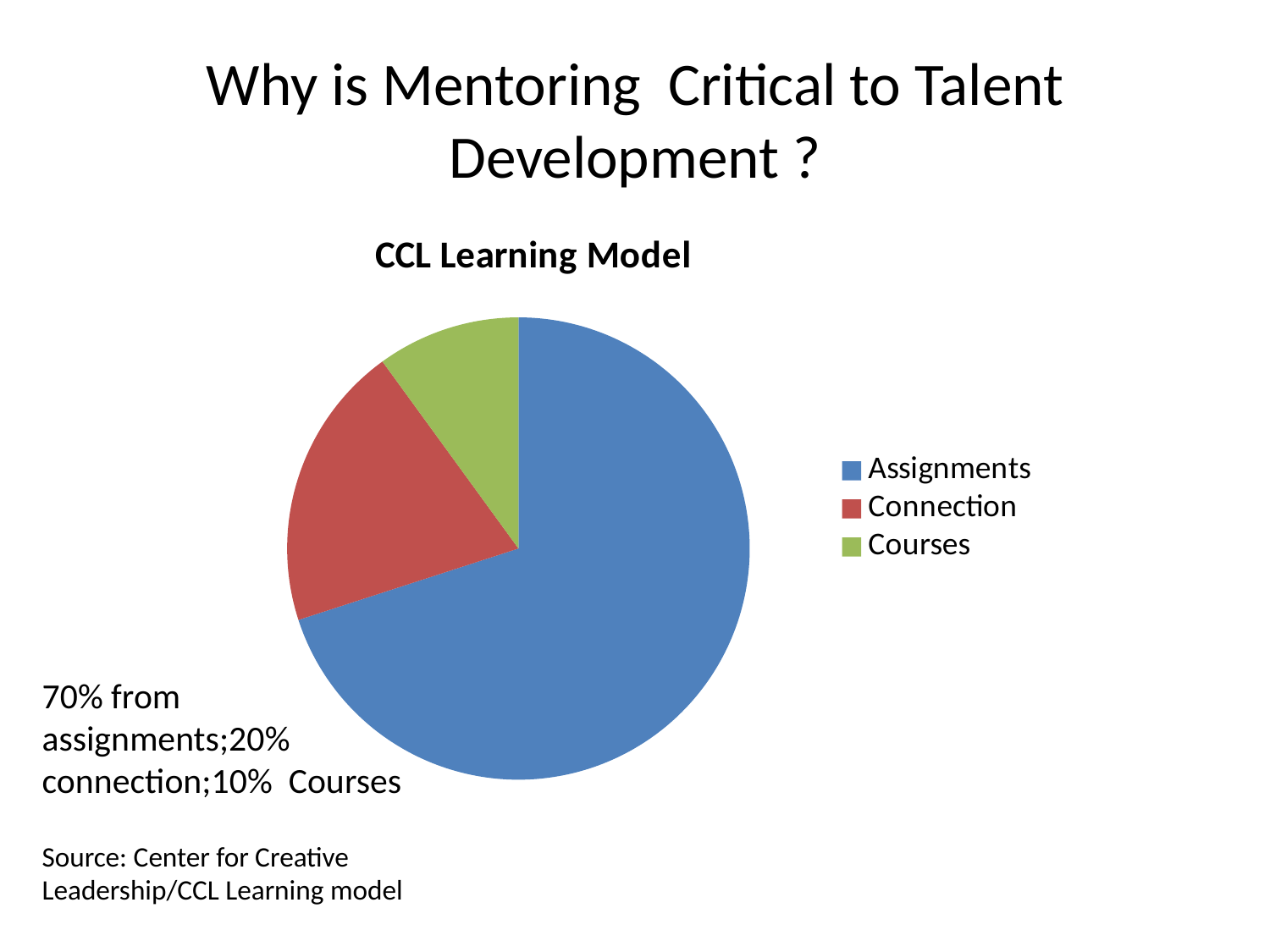
What is the difference in percentage points between the Assignments share and the Connection share? 50% What colour is the Assignments slice in the pie chart? Blue Which category has the largest slice of the pie? Assignments How many entries does the legend list? 3 Which is larger, the Connection slice or the Courses slice? Connection What share of the pie does Assignments represent? 70% What share of the pie does Connection represent? 20% What is the title of the chart? CCL Learning Model Which category has the smallest slice of the pie? Courses How many slices does the pie chart have? 3 What share of the pie does Courses represent? 10% What kind of chart is shown on the slide? Pie chart